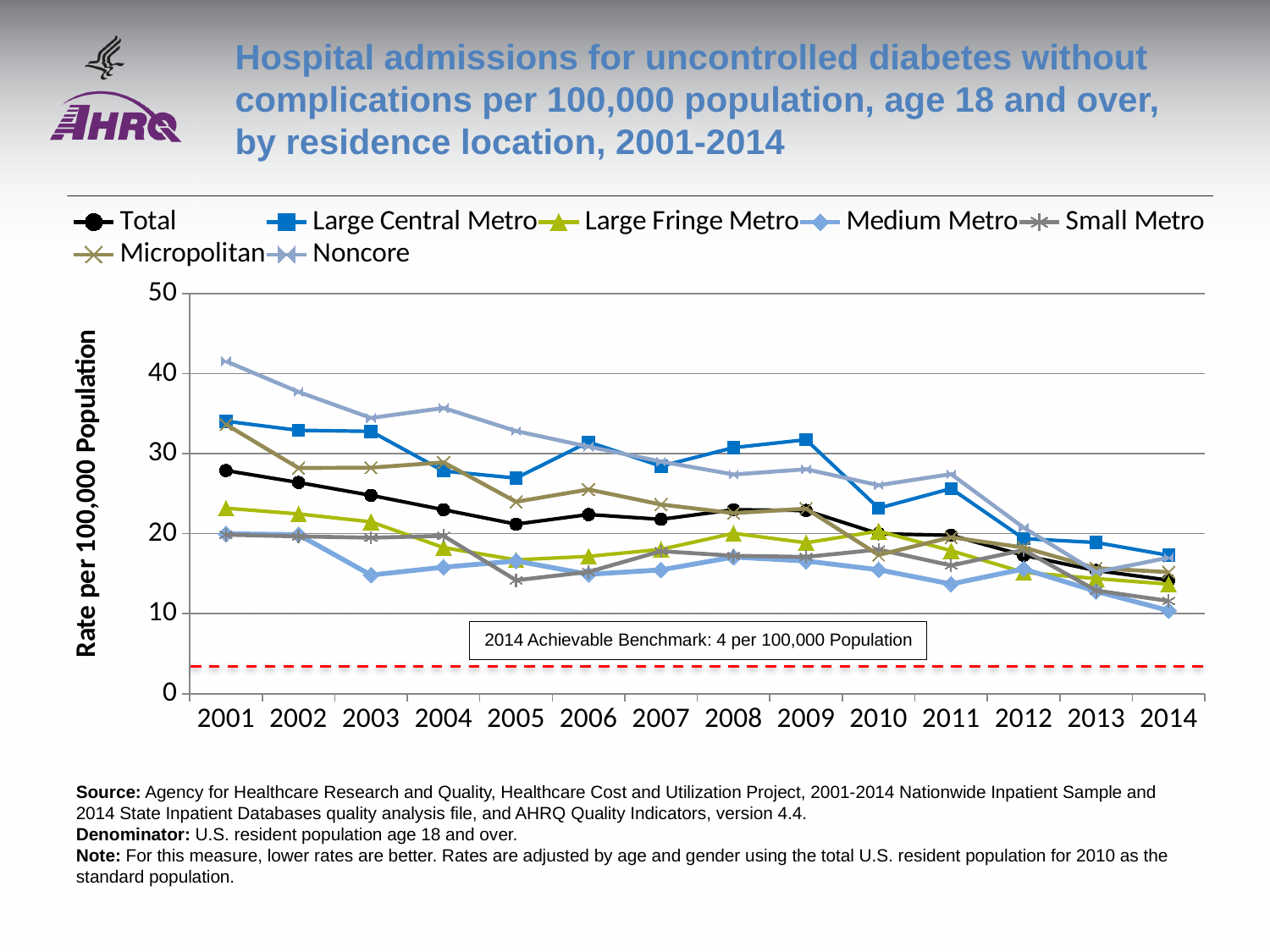
Which residence location had the highest rate in 2009? Large Central Metro Is the value for Total in 2001 greater or less than 30? less What is the 2014 achievable benchmark shown on the chart? 4 per 100,000 Population Which residence location had the highest rate in 2001? Noncore Is the value for Large Central Metro in 2001 greater or less than 30? greater What kind of chart is shown on the slide? Line chart Is the value for Noncore in 2001 greater or less than 40? greater Does the Noncore rate rise or fall from 2001 to 2014? Fall How many years are plotted along the x axis? 14 How many series does the legend list? 7 What is the label of the y axis? Rate per 100,000 Population